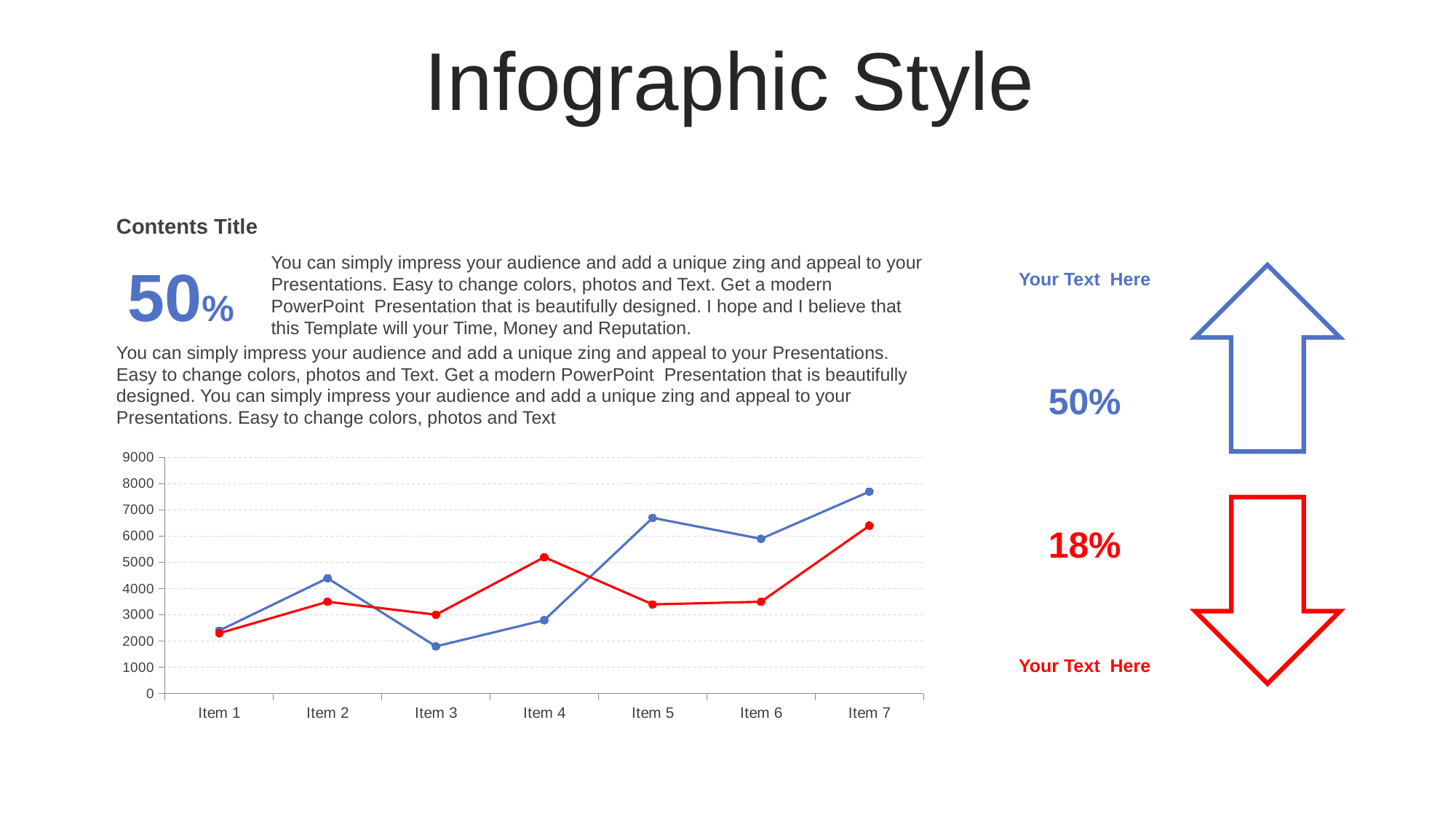
At which item does the blue line reach its highest value? Item 7 At which item does the red line reach its lowest value? Item 1 Is the value of the red line at Item 7 greater or less than 6000? greater What kind of chart is shown on the slide? Line chart At Item 4, which line has the higher value, the blue line or the red line? Red line At which item does the red line reach its highest value? Item 7 How many categories are shown on the x axis of the chart? 7 Is the value of the blue line at Item 3 greater or less than 2000? less At which item does the blue line reach its lowest value? Item 3 How many lines are plotted on the chart? 2 Is the value of the blue line at Item 7 greater or less than 7000? greater Does the blue line rise or fall from Item 5 to Item 6? Fall